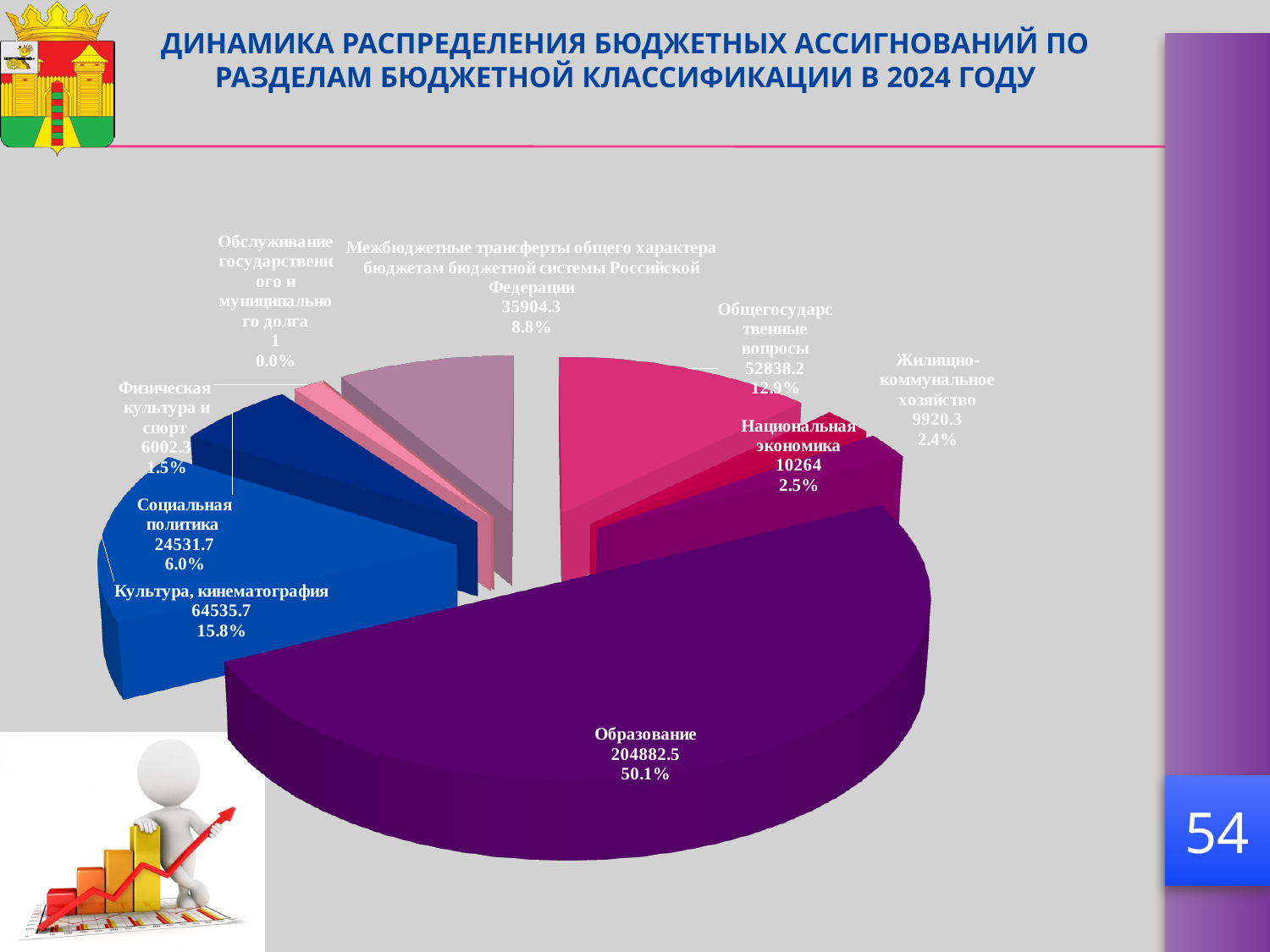
What share of the pie does Общегосударственные вопросы represent? 12.9% How many categories are shown in the pie chart? 9 What is the value for Культура, кинематография? 64535.7 What is the difference between the values for Культура, кинематография and Социальная политика? 40004 Which category has the largest share of the pie? Образование What share of the pie does Физическая культура и спорт represent? 1.5% What share of the pie does Образование represent? 50.1% Which is larger, the value for Национальная экономика or the value for Жилищно-коммунальное хозяйство? Национальная экономика What is the value for Межбюджетные трансферты общего характера бюджетам бюджетной системы Российской Федерации? 35904.3 What kind of chart is shown on the slide? Pie chart Which category has the smallest share of the pie? Обслуживание государственного и муниципального долга What is the value for Образование? 204882.5